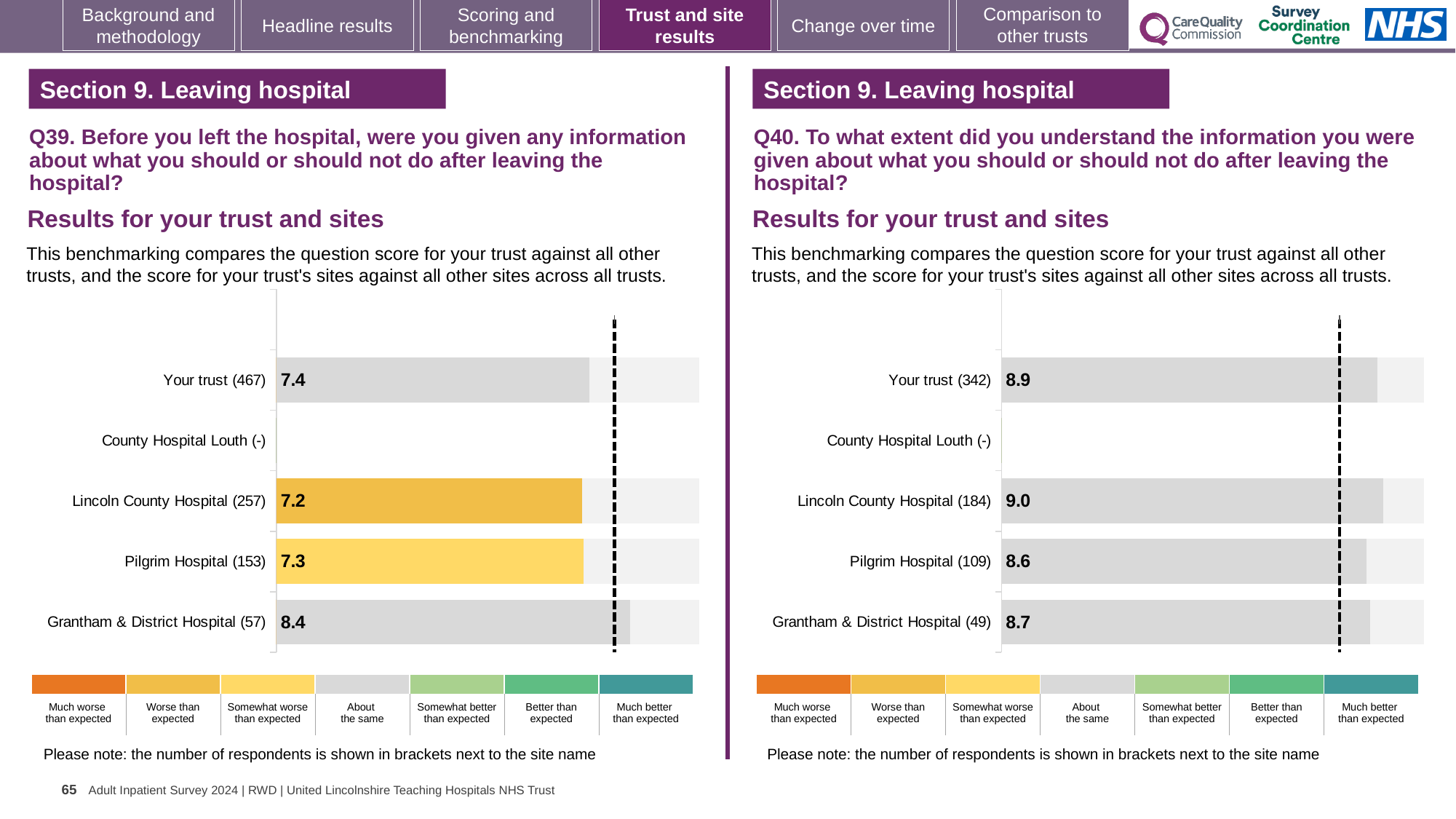
In the Q39 chart on the left, how many respondents are shown in brackets for Lincoln County Hospital? 257 In the Q40 chart on the right, which is larger, the score for Your trust or the score for Grantham & District Hospital? Your trust In the Q39 chart on the left, which site has the lowest score? Lincoln County Hospital In the Q39 chart on the left, what is the score for Your trust? 7.4 What type of chart is used in the Q39 chart on the left? Bar chart In the Q40 chart on the right, what is the score for Pilgrim Hospital? 8.6 In the Q39 chart on the left, what is the difference between the scores for Grantham & District Hospital and Pilgrim Hospital? 1.1 In the Q39 chart on the left, what colour is the bar for Lincoln County Hospital? Amber (orange-yellow) In the Q40 chart on the right, how many categories are listed on the vertical axis? 5 In the Q40 chart on the right, which site has the highest score? Lincoln County Hospital In the Q40 chart on the right, what is the difference between the scores for Lincoln County Hospital and Pilgrim Hospital? 0.4 In the Q39 chart on the left, what is the score for Grantham & District Hospital? 8.4